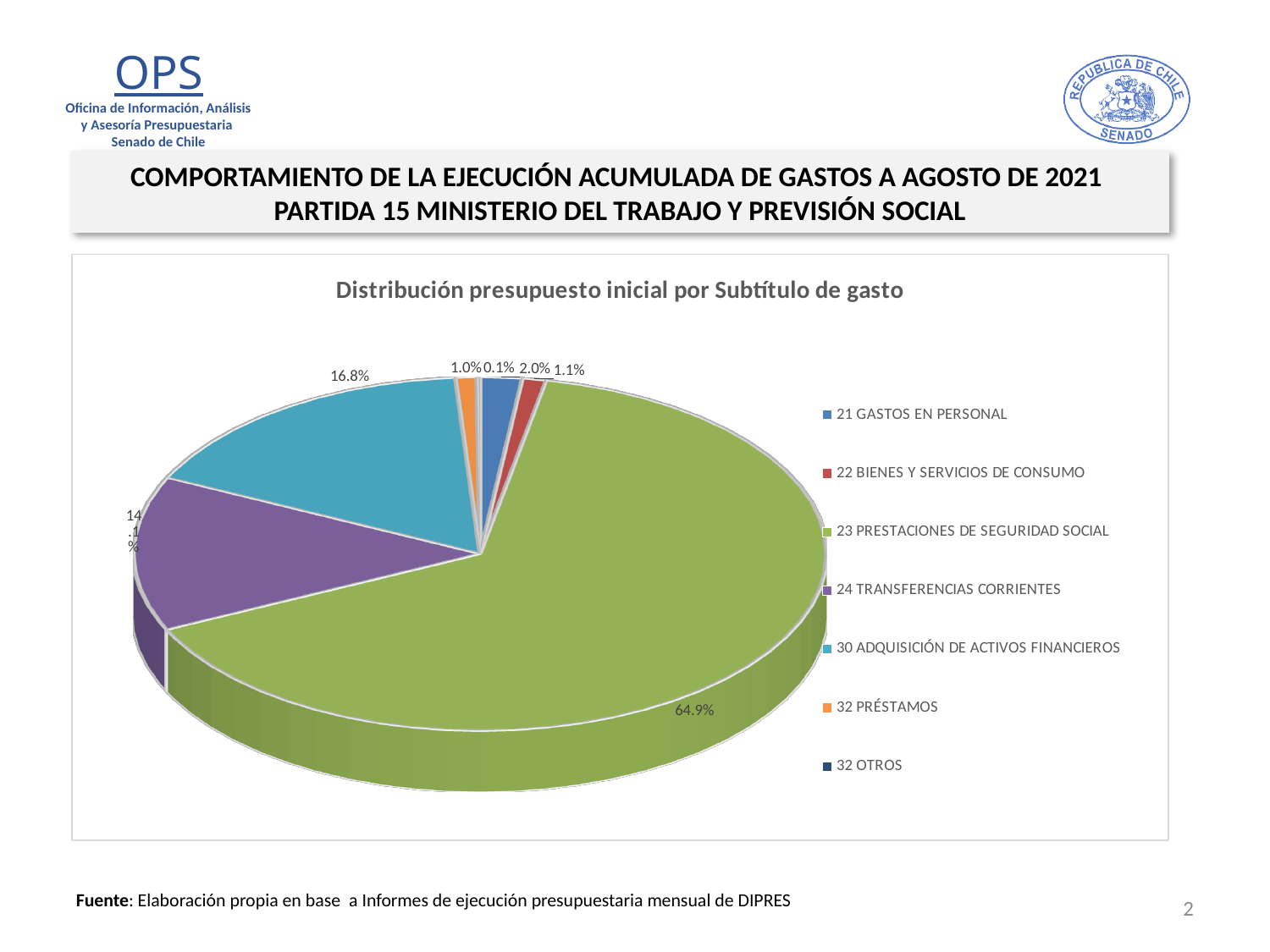
Which subtítulo has the largest share of the pie? 23 PRESTACIONES DE SEGURIDAD SOCIAL What share of the pie does 21 GASTOS EN PERSONAL represent? 2.0% How many entries does the chart legend list? 7 What share of the pie does 22 BIENES Y SERVICIOS DE CONSUMO represent? 1.1% Which has a larger share, 30 ADQUISICIÓN DE ACTIVOS FINANCIEROS or 24 TRANSFERENCIAS CORRIENTES? 30 ADQUISICIÓN DE ACTIVOS FINANCIEROS Which subtítulo has the smallest share of the pie? 32 OTROS What is the title of the chart? Distribución presupuesto inicial por Subtítulo de gasto What is the difference in percentage points between the shares of 30 ADQUISICIÓN DE ACTIVOS FINANCIEROS and 24 TRANSFERENCIAS CORRIENTES? 2.7 What kind of chart is shown on the slide? pie chart What share of the pie does 23 PRESTACIONES DE SEGURIDAD SOCIAL represent? 64.9%